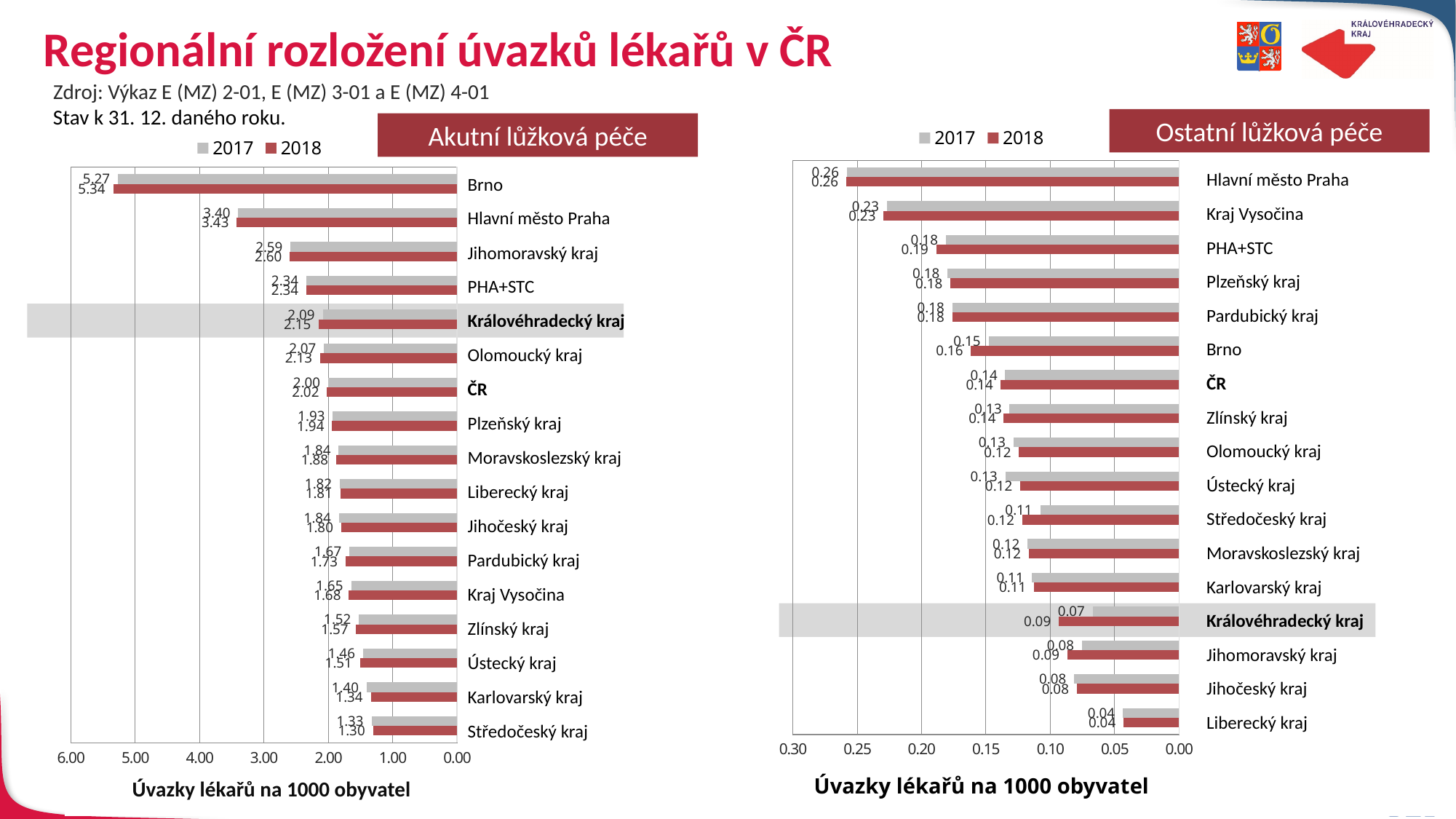
In the 'Akutní lůžková péče' chart, what is the 2018 value for Brno? 5.34 What type of chart is the 'Akutní lůžková péče' chart? bar chart In the 'Ostatní lůžková péče' chart, what is the 2018 value for Královéhradecký kraj? 0.09 In the 'Akutní lůžková péče' chart, how many categories are shown? 17 In the 'Ostatní lůžková péče' chart, which category has the highest 2018 value? Hlavní město Praha In the 'Akutní lůžková péče' chart, what is the difference between the 2018 values for Brno and Hlavní město Praha? 1.91 In the 'Ostatní lůžková péče' chart, is the 2018 value for Kraj Vysočina larger or smaller than the 2018 value for Brno? larger In the 'Akutní lůžková péče' chart, what is the 2017 value for Královéhradecký kraj? 2.09 In the 'Ostatní lůžková péče' chart, which category has the lowest 2017 value? Liberecký kraj In the 'Akutní lůžková péče' chart, which category has the lowest 2018 value? Středočeský kraj In the 'Akutní lůžková péče' chart, which category has the highest 2018 value? Brno How many series does the legend of the 'Ostatní lůžková péče' chart list? 2